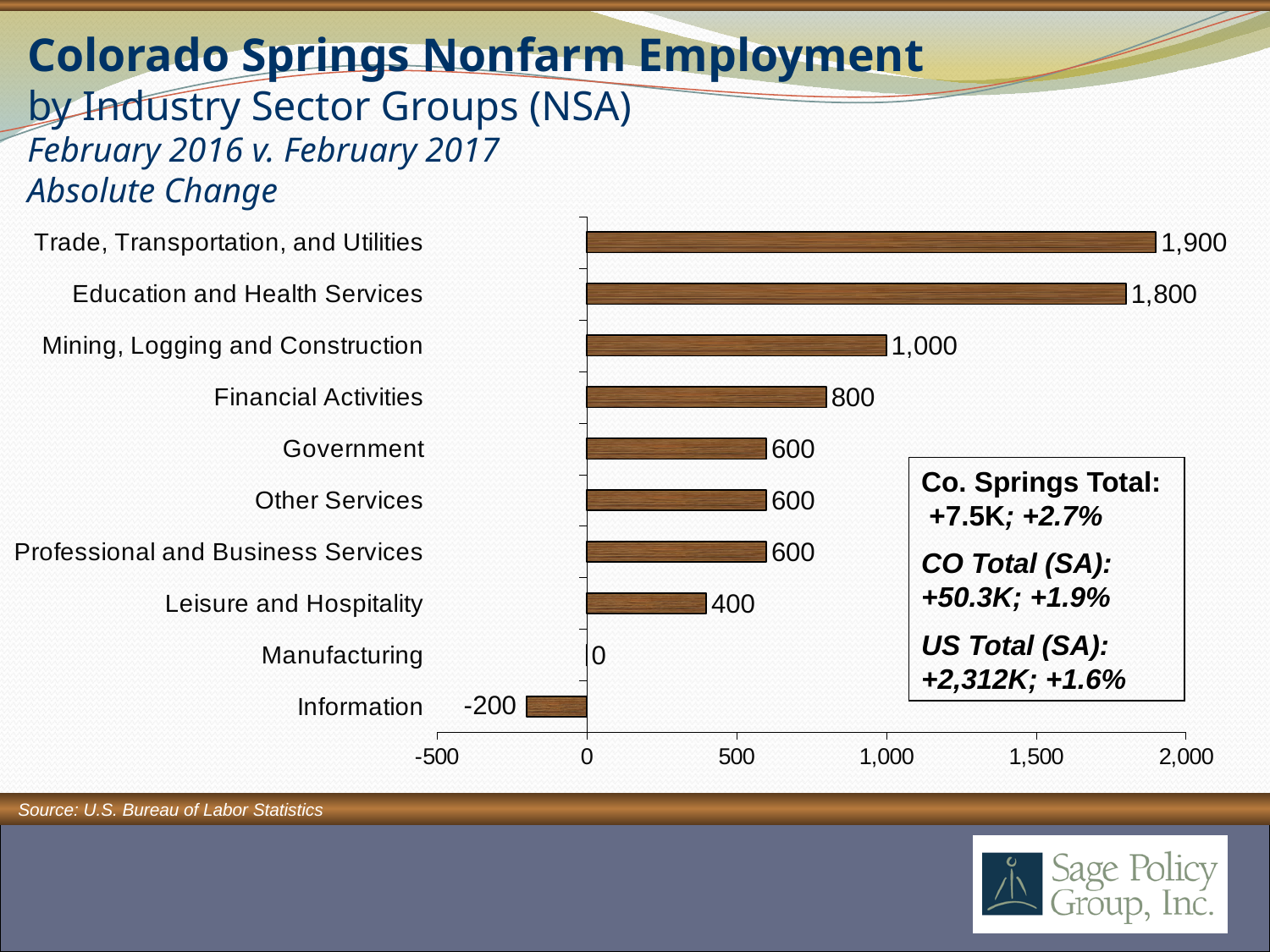
What is the absolute change in employment for Information? -200 Which has a larger absolute change, Leisure and Hospitality or Government? Government What is the absolute change in employment for Manufacturing? 0 How many industry sector groups are shown in the chart? 10 Which industry sector group has the highest absolute change? Trade, Transportation, and Utilities Which industry sector group has the lowest absolute change? Information What is the difference between the absolute change for Education and Health Services and Financial Activities? 1,000 What is the source cited for the chart data? U.S. Bureau of Labor Statistics What is the Co. Springs Total change shown in the text box on the chart? +7.5K; +2.7% What is the absolute change in employment for Mining, Logging and Construction? 1,000 What kind of chart is shown on the slide? Bar chart What is the absolute change in employment for Trade, Transportation, and Utilities? 1,900